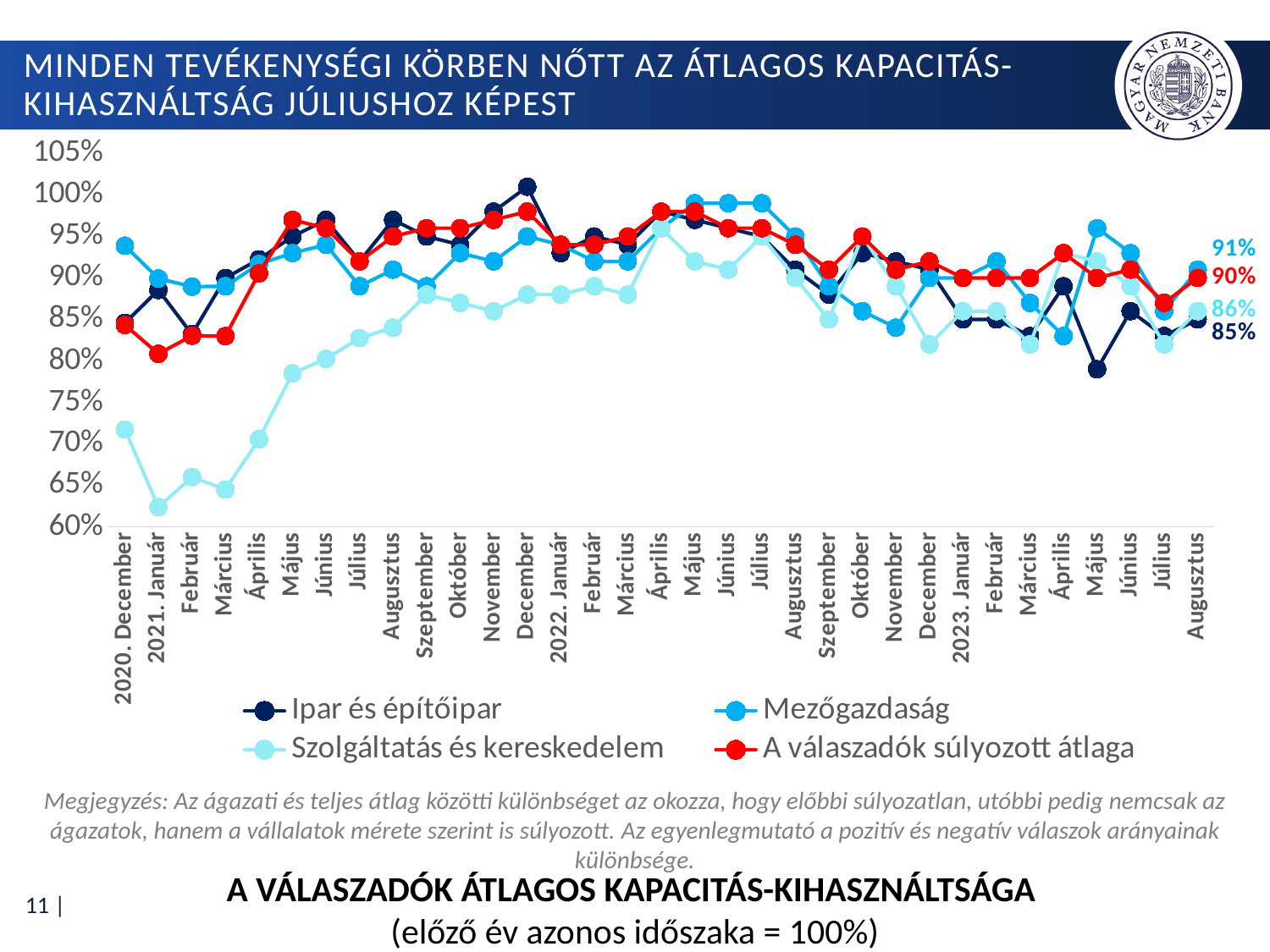
Which series has the highest value in 2023 Augusztus? Mezőgazdaság Is the value for Ipar és építőipar in 2021 December greater or less than 100%? greater What is the value for Mezőgazdaság in 2023 Augusztus? 91% What is the difference between the Mezőgazdaság and Ipar és építőipar values in 2023 Augusztus? 6 percentage points What kind of chart is shown on the slide? Line chart What is the value for A válaszadók súlyozott átlaga in 2023 Augusztus? 90% How many series does the legend list? 4 Which colour is used for the series A válaszadók súlyozott átlaga? Red What is the value for Ipar és építőipar in 2023 Augusztus? 85% Which series has the lowest value in 2020 December? Szolgáltatás és kereskedelem What is the value for Szolgáltatás és kereskedelem in 2023 Augusztus? 86% Is the value for Szolgáltatás és kereskedelem in 2021 Január greater or less than 65%? less